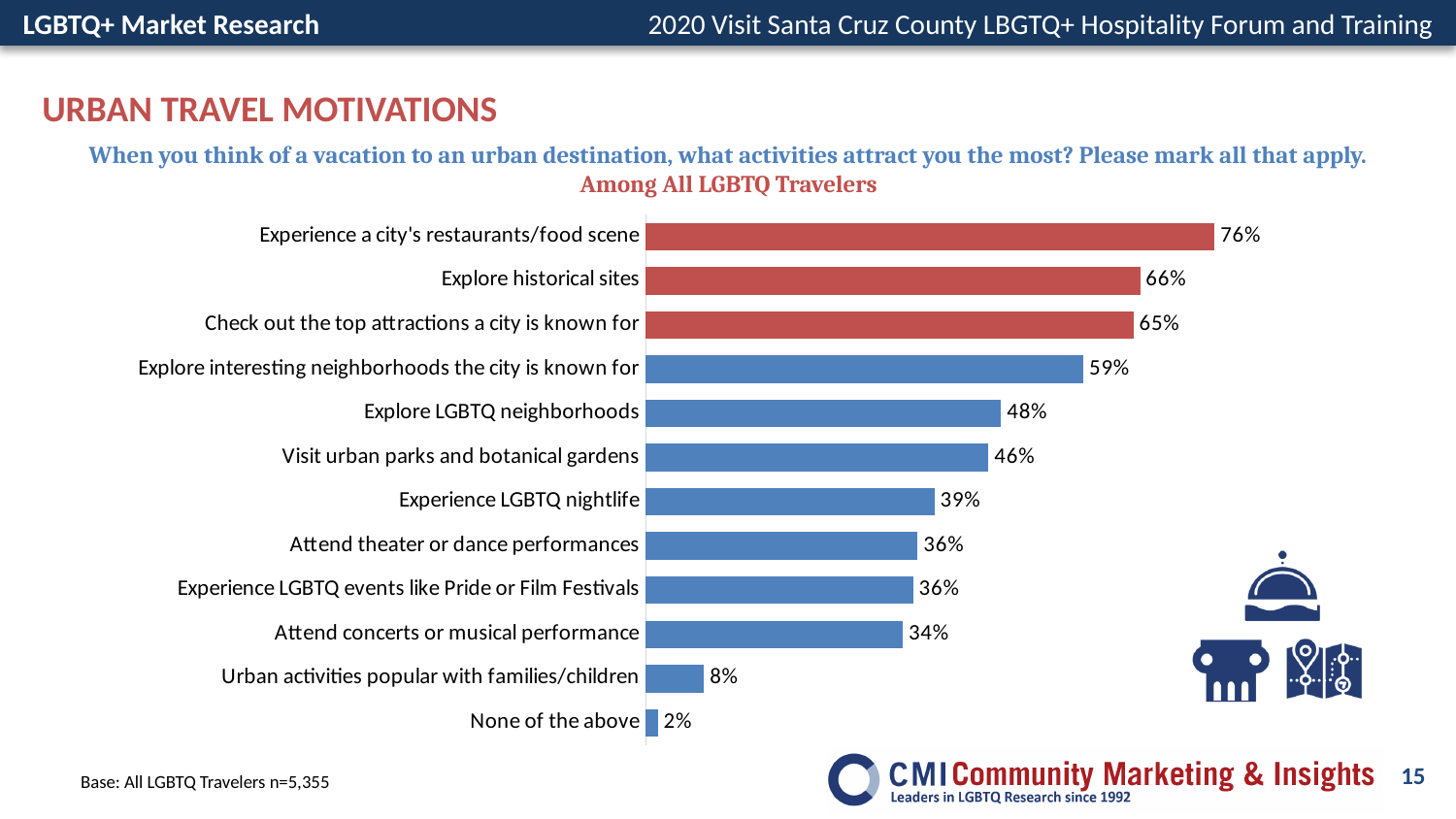
What is the base sample size stated on the slide? n=5,355 What is the difference in percentage points between 'Explore historical sites' and 'Experience LGBTQ nightlife'? 27 Which is larger: the value for 'Visit urban parks and botanical gardens' or the value for 'Attend concerts or musical performance'? Visit urban parks and botanical gardens What type of chart is used on this slide? Bar chart Which category has the lowest percentage on the chart? None of the above What is the value shown for 'Explore LGBTQ neighborhoods'? 48% How many categories are shown on the chart? 12 What percentage of LGBTQ travelers selected 'Experience a city's restaurants/food scene' as an urban travel motivation? 76% How many categories are shown with red bars? 3 Which urban travel motivation has the highest percentage? Experience a city's restaurants/food scene What is the difference between the highest value and the lowest value on the chart, in percentage points? 74 What percentage is shown for 'Urban activities popular with families/children'? 8%